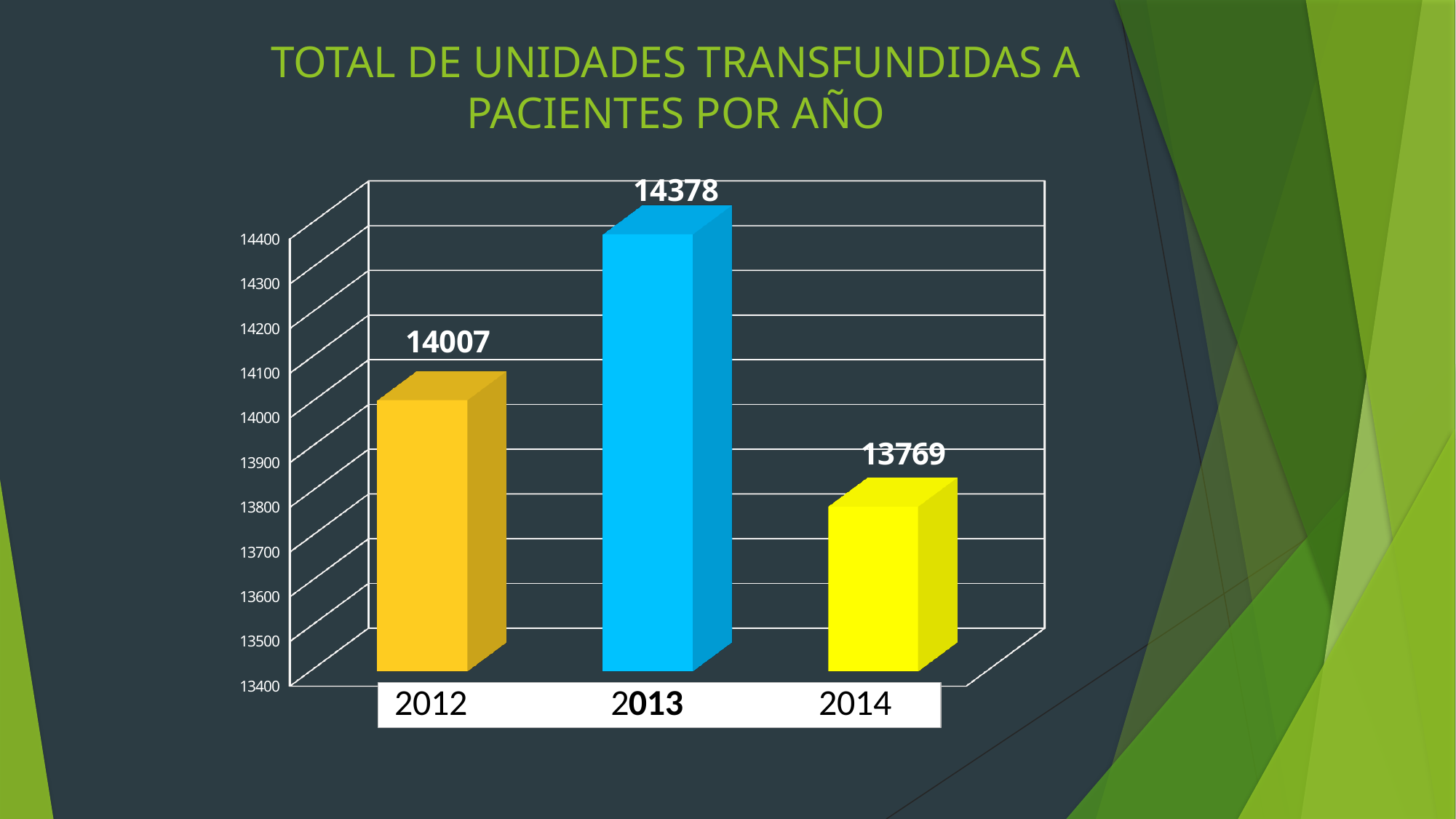
What is the value for 2013? 14378 Which is larger, the value for 2012 or the value for 2014? 2012 Which year has the lowest value? 2014 What is the difference between the values for 2013 and 2012? 371 What is the value for 2012? 14007 What is the title of the chart? TOTAL DE UNIDADES TRANSFUNDIDAS A PACIENTES POR AÑO What is the value for 2014? 13769 Is the value for 2014 greater or less than 13800? less How many years are shown on the chart? 3 What is the difference between the values for 2012 and 2014? 238 What kind of chart is shown on the slide? bar chart Which year has the highest value? 2013